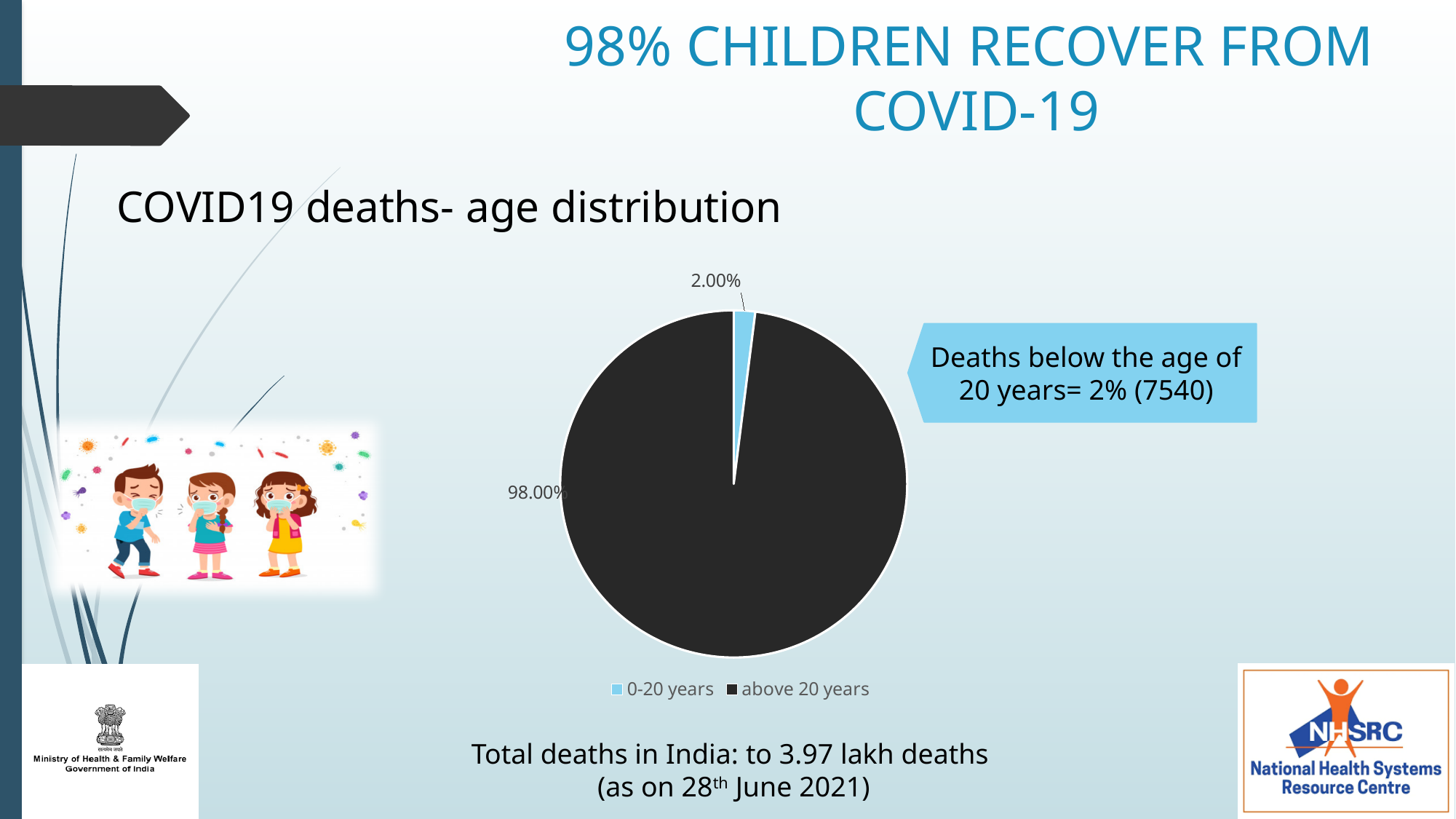
How many slices does the pie chart have? 2 Which age group has the smallest slice of the pie? 0-20 years What colour is the 0-20 years slice? light blue What share of COVID19 deaths is shown for the 0-20 years slice? 2.00% What is the difference in percentage points between the above 20 years slice and the 0-20 years slice? 96.00% What is the title of the chart? COVID19 deaths- age distribution Which slice is larger, 0-20 years or above 20 years? above 20 years What kind of chart is shown on the slide? pie chart How many entries does the legend list? 2 Which age group has the largest slice of the pie? above 20 years What share of COVID19 deaths is shown for the above 20 years slice? 98.00%